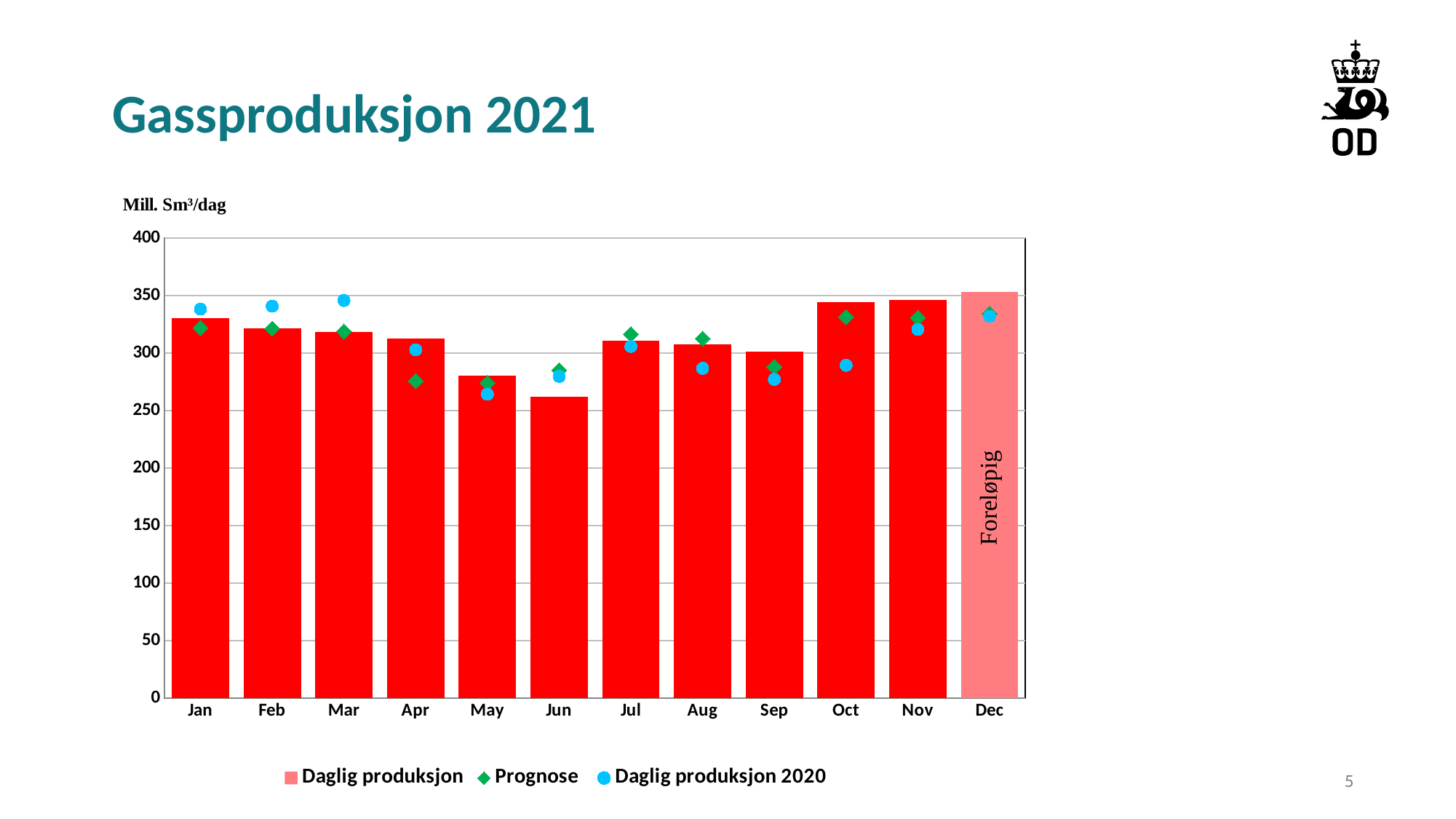
Do the Daglig produksjon bars rise or fall from Jan to Jun? Fall How many months are shown on the x axis of the chart? 12 How many series does the chart legend list? 3 Is the Daglig produksjon value for Jun greater or less than 250? greater What word is written on the Dec bar of the chart? Foreløpig Which month has the lowest Daglig produksjon bar? Jun What kind of chart is shown on the slide? Bar chart Is the Daglig produksjon value for Oct greater or less than 300? greater Is the Daglig produksjon value for Jun greater or less than 300? less What unit is shown above the y axis of the chart? Mill. Sm³/dag Which month has the larger Daglig produksjon bar, Jan or Jun? Jan